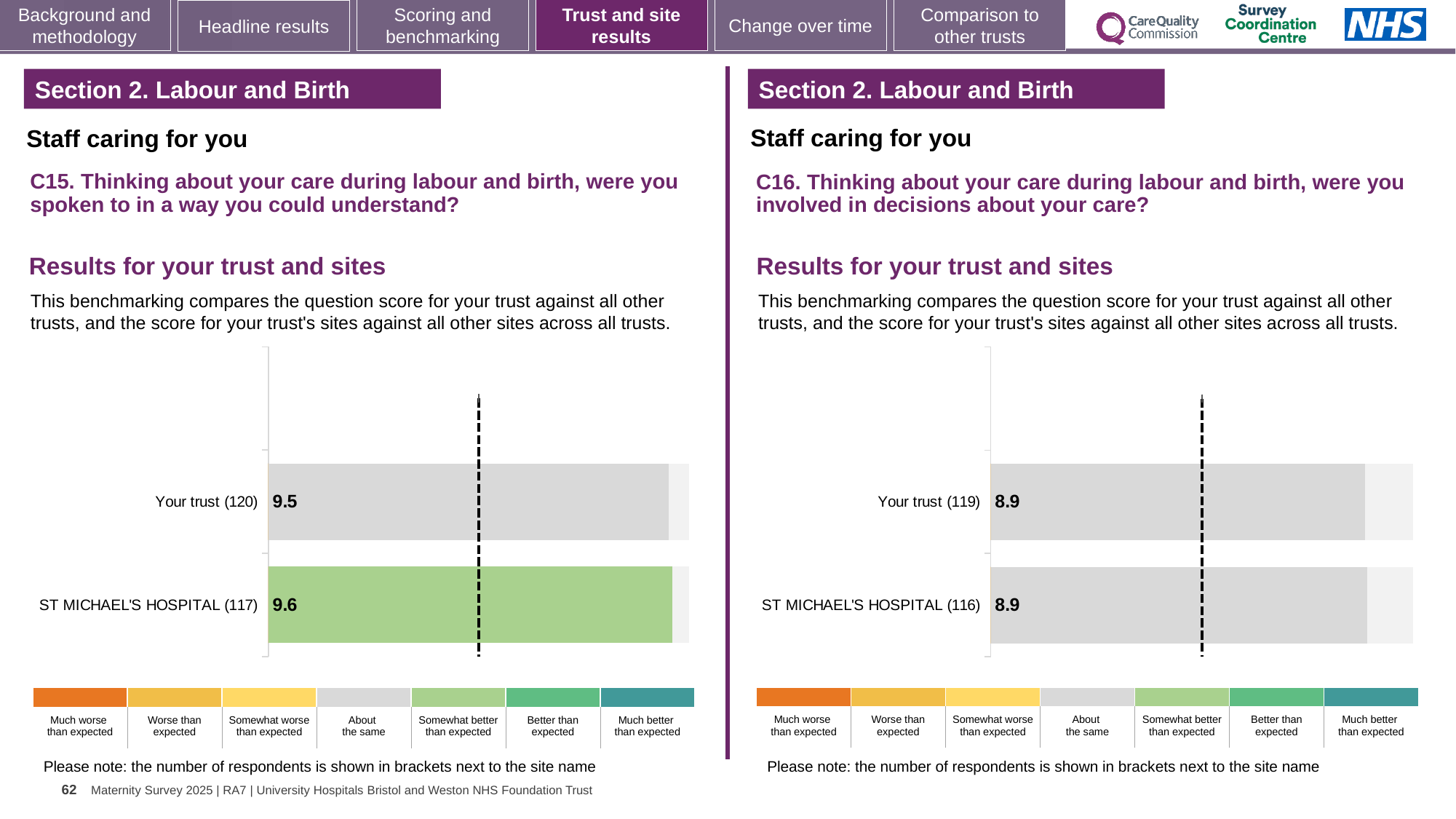
In the C15 chart on the left, what is the score for Your trust? 9.5 In the C16 chart on the right, how many respondents are shown in brackets for Your trust? 119 In the C15 chart on the left, which has the higher score: Your trust or ST MICHAEL'S HOSPITAL? ST MICHAEL'S HOSPITAL In the C16 chart on the right, what is the difference between the Your trust score and the ST MICHAEL'S HOSPITAL score? 0 In the C16 chart on the right, what is the score for ST MICHAEL'S HOSPITAL? 8.9 In the C15 chart on the left, how many respondents are shown in brackets for ST MICHAEL'S HOSPITAL? 117 In the C15 chart on the left, what is the difference between the ST MICHAEL'S HOSPITAL score and the Your trust score? 0.1 What type of chart is used in the C16 chart on the right? Bar chart In the C15 chart on the left, what is the score for ST MICHAEL'S HOSPITAL? 9.6 In the C16 chart on the right, what is the score for Your trust? 8.9 In the C15 chart on the left, which benchmark category does the green colour of the ST MICHAEL'S HOSPITAL bar represent according to the legend? Somewhat better than expected How many bars are plotted in the C15 chart on the left? 2